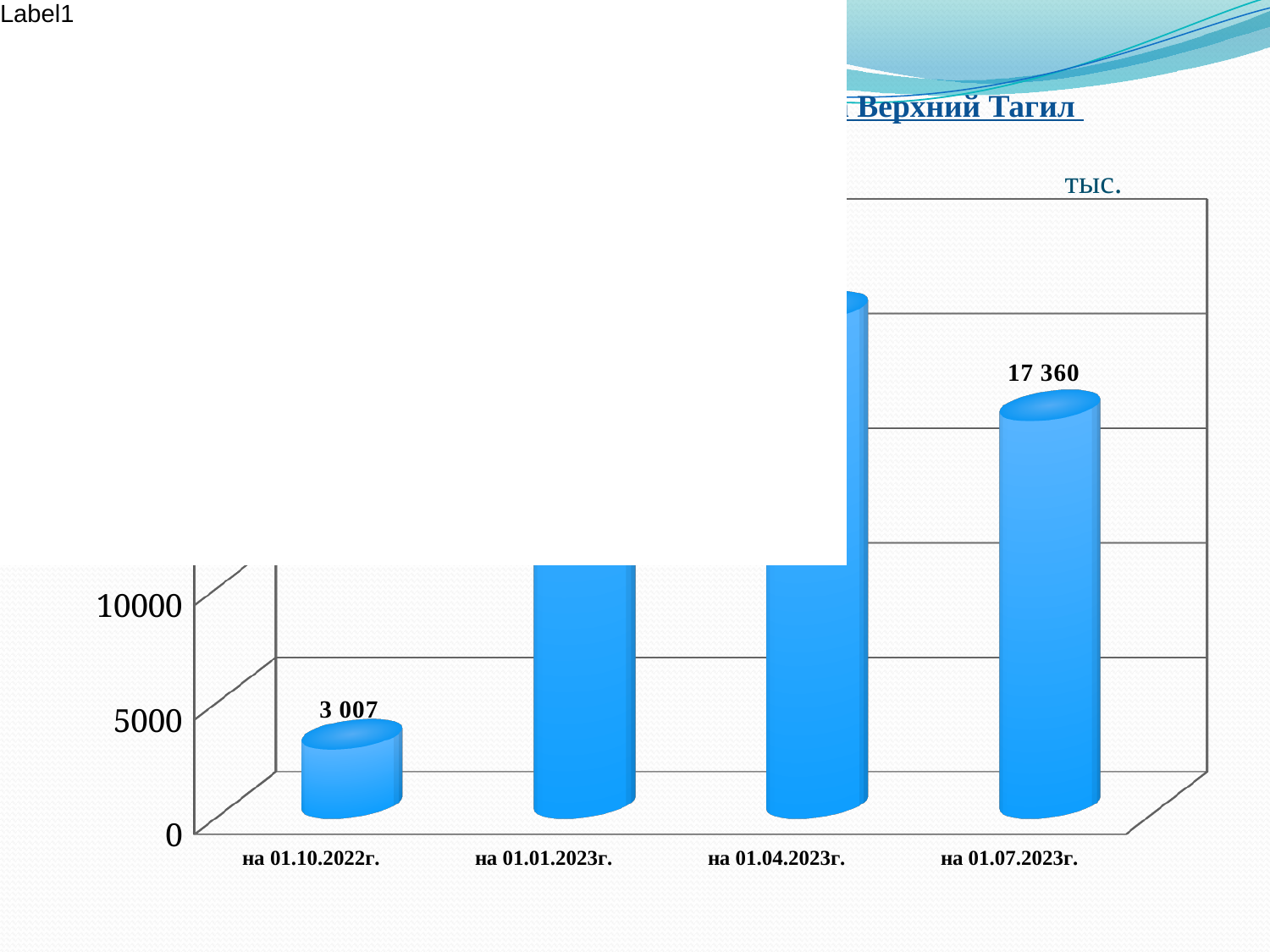
What unit label is shown above the chart's value axis? тыс. Which bar is taller, на 01.04.2023г. or на 01.07.2023г.? на 01.04.2023г. What is the difference between the values for на 01.07.2023г. and на 01.10.2022г.? 14 353 What is the value for на 01.07.2023г.? 17 360 Is the value for на 01.01.2023г. greater or less than 10000? greater Is the value for на 01.10.2022г. greater or less than 5000? less What kind of chart is shown on the slide? bar chart How many categories are shown on the x axis? 4 Which is larger, the value for на 01.07.2023г. or the value for на 01.10.2022г.? на 01.07.2023г. Which category has the lowest value? на 01.10.2022г. What is the value for на 01.10.2022г.? 3 007